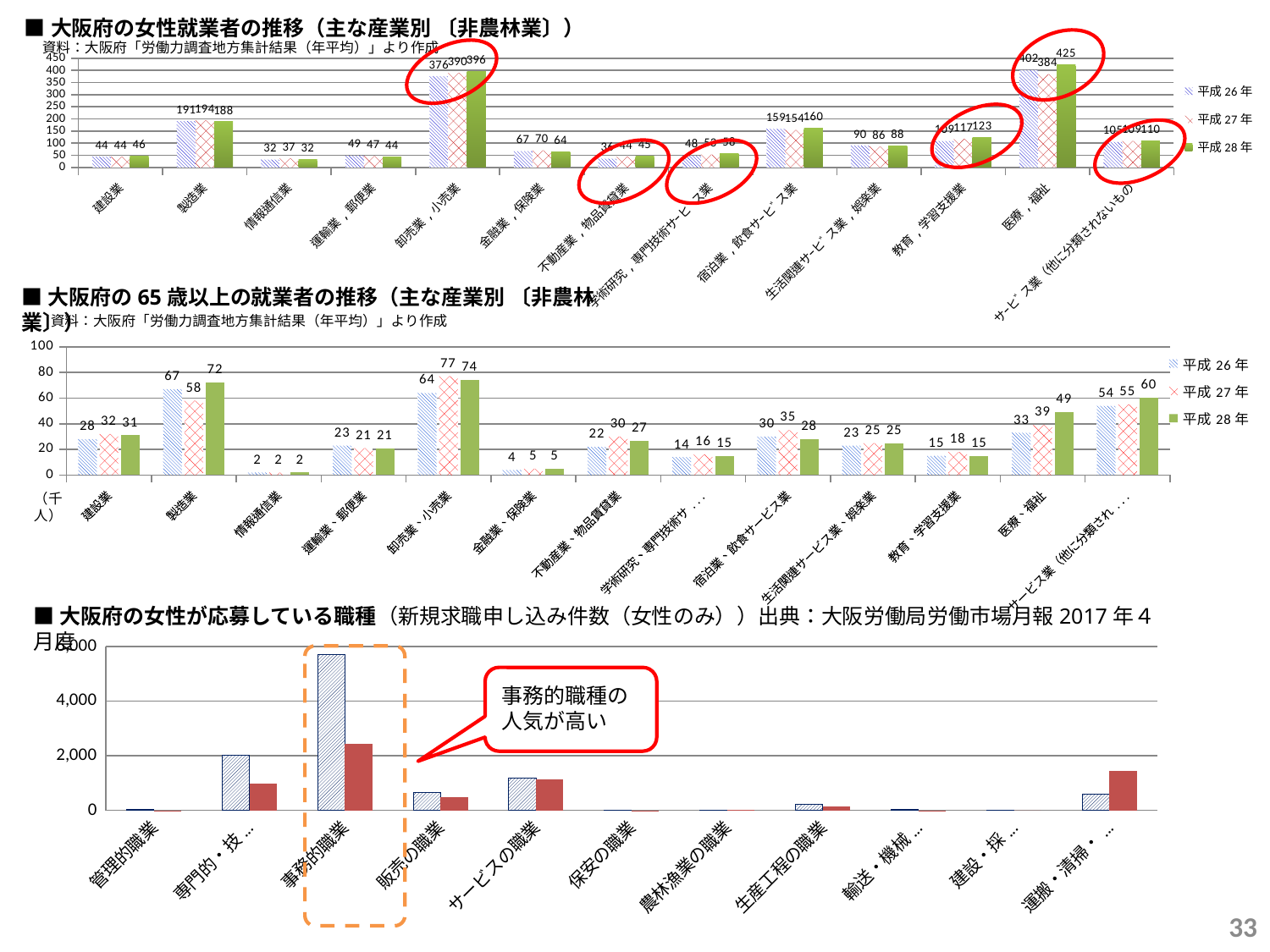
In the middle chart (大阪府の65歳以上の就業者の推移), how many industry categories are shown? 13 In the top chart (大阪府の女性就業者の推移), what is the 平成26年 value for 卸売業，小売業? 376 In the top chart (大阪府の女性就業者の推移), which industry has the highest 平成28年 value? 医療，福祉 In the middle chart (大阪府の65歳以上の就業者の推移), how do the values for 医療、福祉 change from 平成26年 to 平成28年? They rise (33, 39, 49) What kind of chart is the bottom chart (大阪府の女性が応募している職種)? Bar chart In the top chart (大阪府の女性就業者の推移), what is the difference between the 平成28年 and 平成26年 values for 教育，学習支援業? 14 In the top chart (大阪府の女性就業者の推移), what is the 平成28年 value for 医療，福祉? 425 In the middle chart (大阪府の65歳以上の就業者の推移), which industry has the lowest 平成28年 value? 情報通信業 In the middle chart (大阪府の65歳以上の就業者の推移), what is the 平成27年 value for 卸売業、小売業? 77 In the bottom chart (大阪府の女性が応募している職種), is the value of the first (blue hatched) bar for 事務的職業 greater or less than 4,000? greater In the top chart (大阪府の女性就業者の推移), how many series does the legend list? 3 In the middle chart (大阪府の65歳以上の就業者の推移), is the 平成28年 value for 医療、福祉 larger than the 平成28年 value for 製造業? No, 製造業 (72) is larger than 医療、福祉 (49)